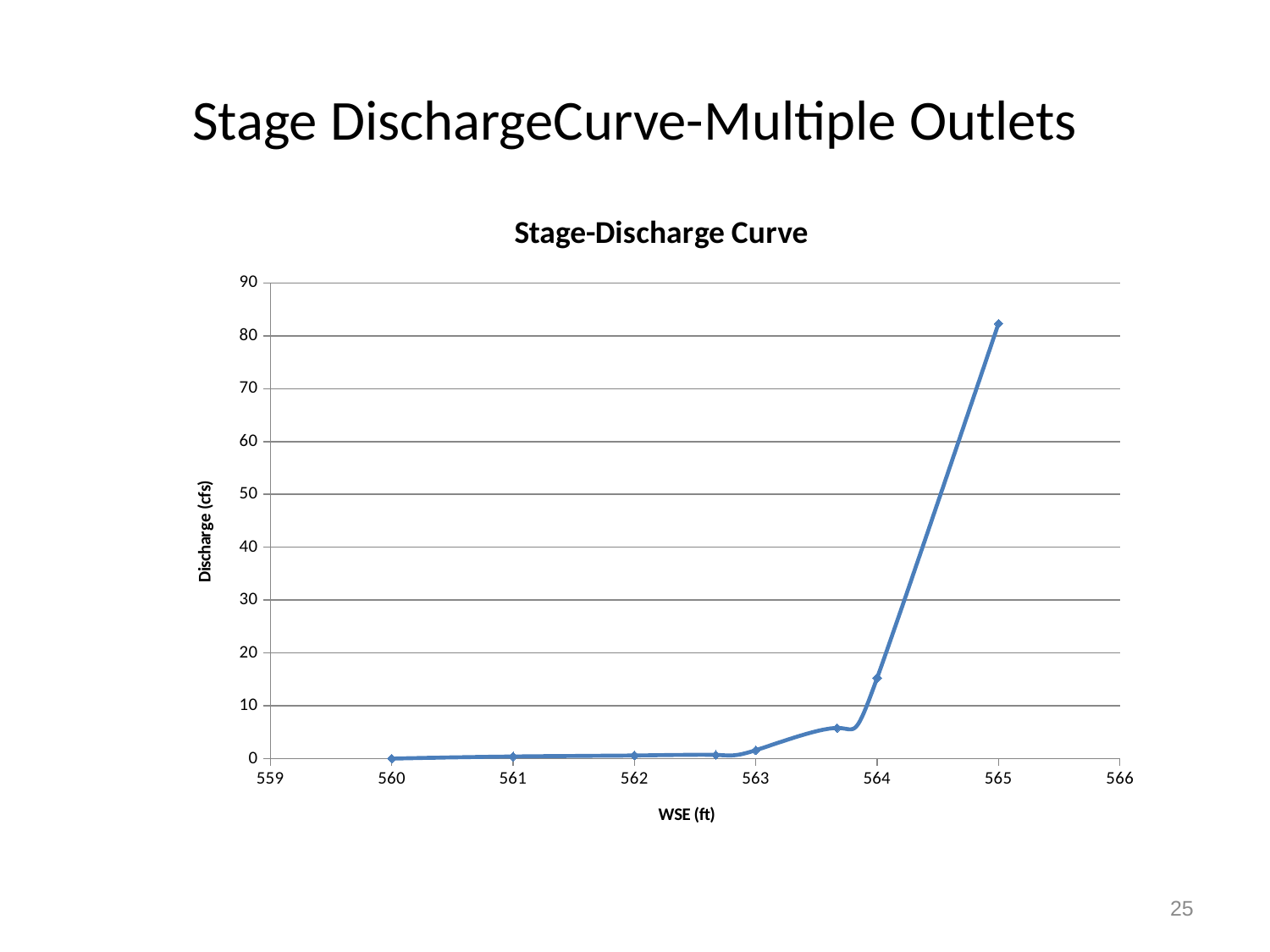
What is the title of the chart? Stage-Discharge Curve How many data points are plotted on the curve? 8 At which WSE value is the discharge highest? 565 Is the discharge at WSE 564 greater or less than 20? less What kind of chart is shown on the slide? line chart Is the discharge at WSE 565 greater or less than 70? greater Is the discharge at WSE 563 greater or less than 10? less What is the label of the vertical axis of the chart? Discharge (cfs) Which has the larger discharge, WSE 564 or WSE 565? 565 Does the discharge rise or fall as WSE increases along the x axis? rise